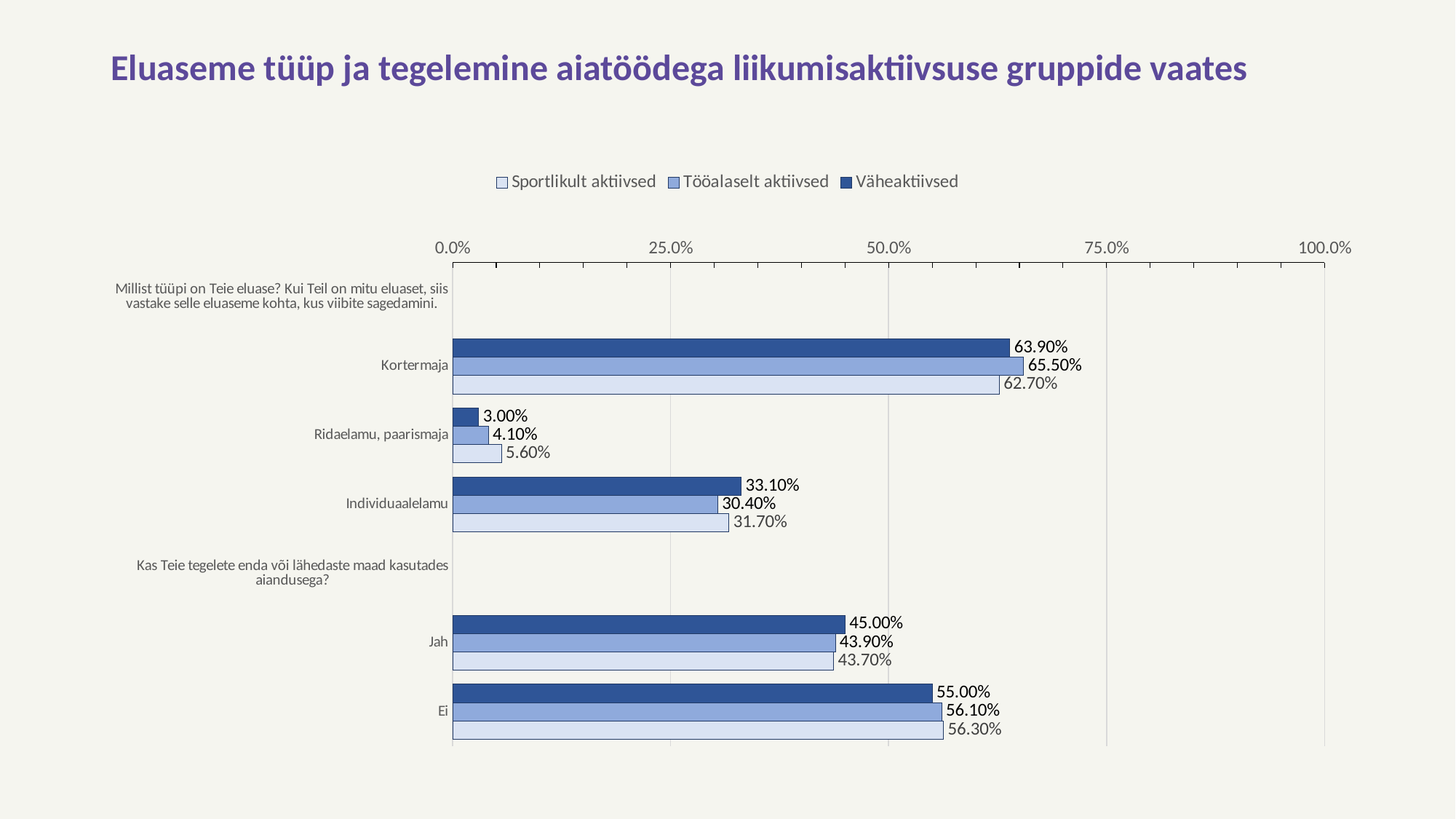
Which housing type category has the highest value for Sportlikult aktiivsed? Kortermaja How many series does the legend list? 3 Which is larger in the Individuaalelamu category: the Väheaktiivsed value or the Tööalaselt aktiivsed value? Väheaktiivsed What kind of chart is shown on the slide? bar chart What is the value for Tööalaselt aktiivsed in the Kortermaja category? 65.50% What is the difference between the Väheaktiivsed values for Ei and Jah? 10.00% What is the value for Sportlikult aktiivsed in the Ridaelamu, paarismaja category? 5.60% What is the title of the chart on the slide? Eluaseme tüüp ja tegelemine aiatöödega liikumisaktiivsuse gruppide vaates What is the value for Sportlikult aktiivsed in the Ei category? 56.30% What is the value for Väheaktiivsed in the Individuaalelamu category? 33.10% Which housing type category has the lowest value for Väheaktiivsed? Ridaelamu, paarismaja What is the value for Väheaktiivsed in the Kortermaja category? 63.90%